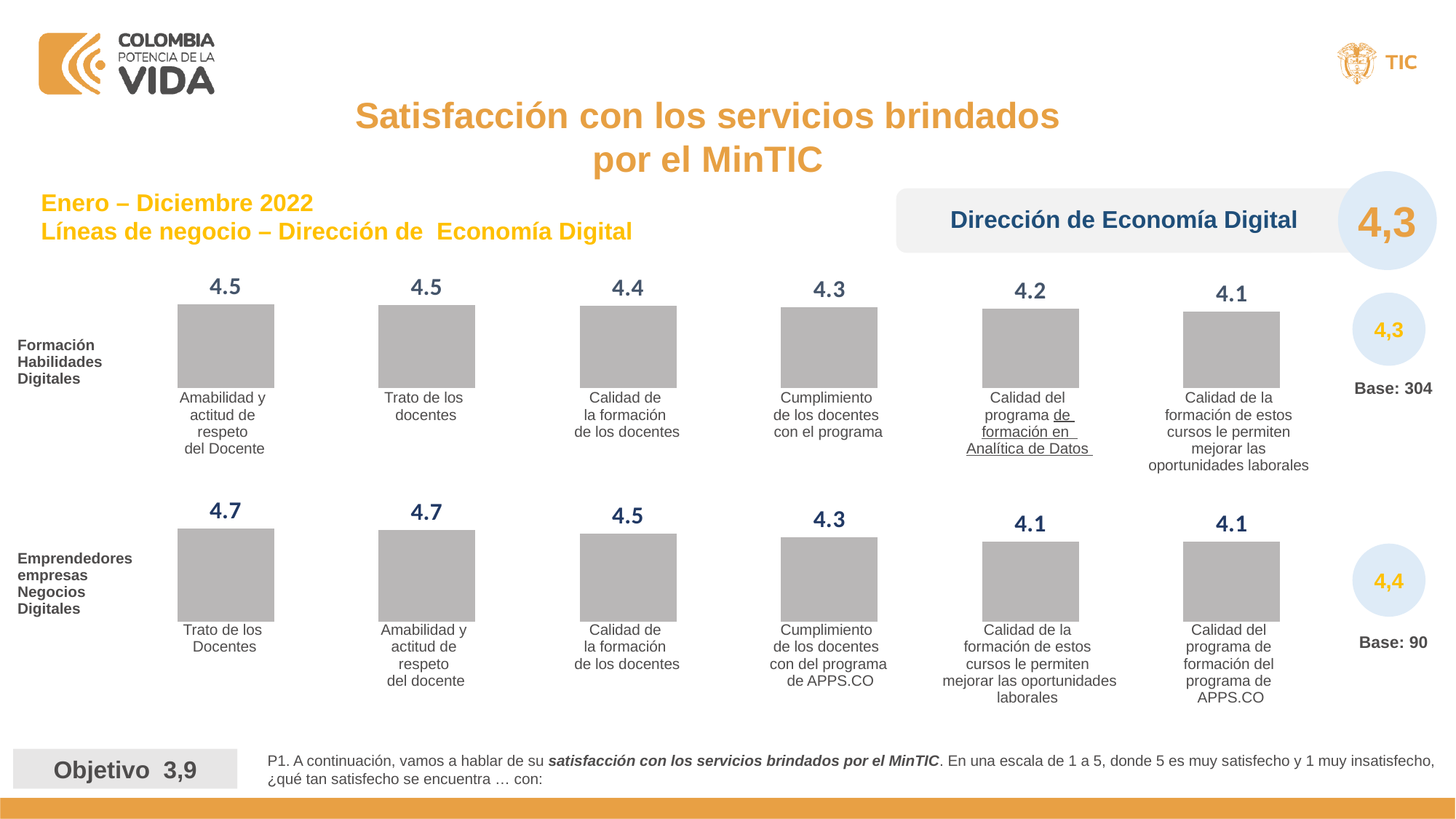
Which is larger: Calidad de la formación de los docentes in the Formación Habilidades Digitales chart or in the Emprendedores empresas Negocios Digitales chart? Emprendedores empresas Negocios Digitales In the Formación Habilidades Digitales chart, what is the value for Calidad de la formación de estos cursos le permiten mejorar las oportunidades laborales? 4.1 In the Formación Habilidades Digitales chart, what is the value for Cumplimiento de los docentes con el programa? 4.3 In the Formación Habilidades Digitales chart, what is the difference between Amabilidad y actitud de respeto del Docente and Calidad del programa de formación en Analítica de Datos? 0.3 What kind of chart is used for the Emprendedores empresas Negocios Digitales row? Bar chart Do the values in the Emprendedores empresas Negocios Digitales chart rise or fall from left to right? Fall In the Emprendedores empresas Negocios Digitales chart, what is the highest value shown? 4.7 In the Emprendedores empresas Negocios Digitales chart, what is the difference between Amabilidad y actitud de respeto del docente and Calidad del programa de formación del programa de APPS.CO? 0.6 In the Emprendedores empresas Negocios Digitales chart, what is the value for Trato de los Docentes? 4.7 In the Emprendedores empresas Negocios Digitales chart, what is the value for Cumplimiento de los docentes con del programa de APPS.CO? 4.3 In the Formación Habilidades Digitales chart, which category has the lowest value? Calidad de la formación de estos cursos le permiten mejorar las oportunidades laborales How many categories are shown in the Formación Habilidades Digitales chart? 6